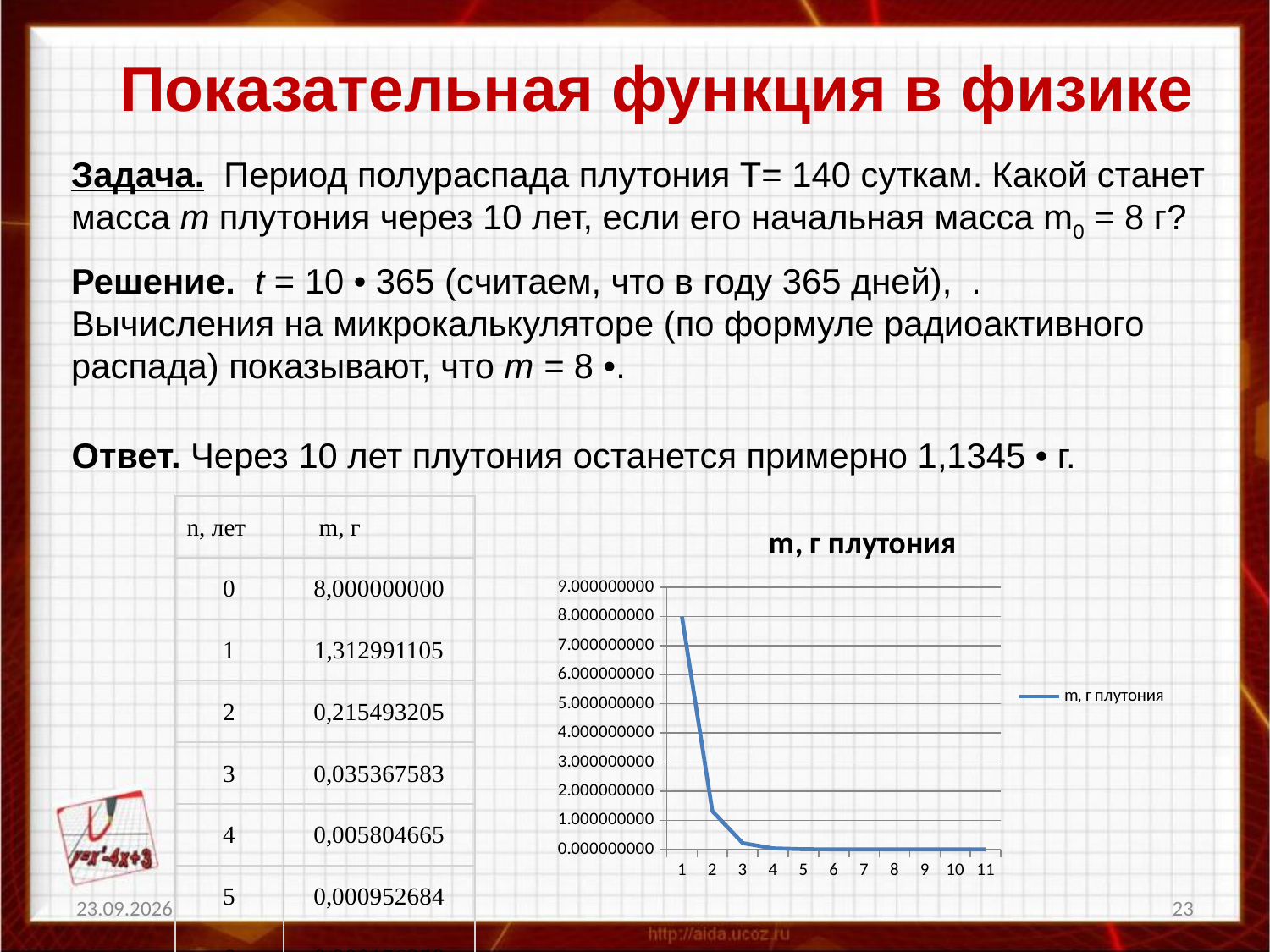
Is the value at x = 3 greater or less than 1.000000000? less What kind of chart is shown on the slide? line chart What is the value of the series at x = 1? 8.000000000 Is the value at x = 1 greater or less than 7.000000000? greater What is the title of the chart? m, г плутония How many points are labelled along the x axis of the chart? 11 Which is larger, the value at x = 1 or the value at x = 2? x = 1 What is the legend entry for the plotted series? m, г плутония At which x value is the series highest? 1 How many series does the chart legend list? 1 Do the values rise or fall as x increases along the axis? fall Is the value at x = 2 greater or less than 2.000000000? less